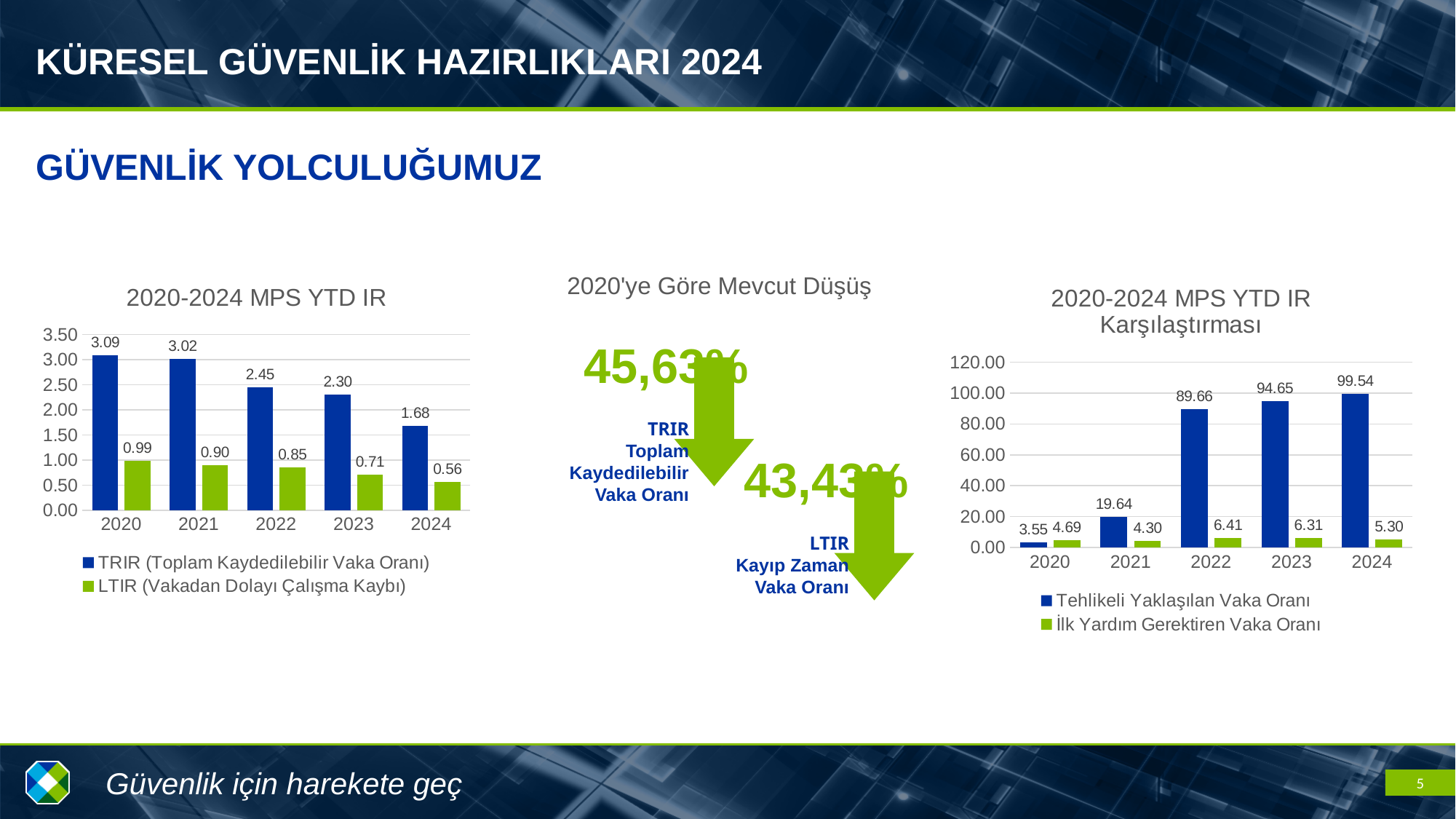
In the chart titled "2020-2024 MPS YTD IR Karşılaştırması", what is the Tehlikeli Yaklaşılan Vaka Oranı value for 2023? 94.65 In the chart titled "2020-2024 MPS YTD IR", does the TRIR value rise or fall from 2020 to 2024? fall In the chart titled "2020-2024 MPS YTD IR", what is the LTIR value for 2024? 0.56 In the chart titled "2020-2024 MPS YTD IR", what is the TRIR value for 2022? 2.45 In the chart titled "2020-2024 MPS YTD IR", how many series does the legend list? 2 In the chart titled "2020-2024 MPS YTD IR", what is the difference between the TRIR values for 2020 and 2024? 1.41 In the chart titled "2020-2024 MPS YTD IR Karşılaştırması", what is the İlk Yardım Gerektiren Vaka Oranı value for 2021? 4.30 In the chart titled "2020-2024 MPS YTD IR", which year has the highest TRIR value? 2020 What kind of chart is the chart titled "2020-2024 MPS YTD IR Karşılaştırması"? bar chart In the chart titled "2020-2024 MPS YTD IR", which year has the lowest LTIR value? 2024 In the chart titled "2020-2024 MPS YTD IR Karşılaştırması", which is larger in 2020: Tehlikeli Yaklaşılan Vaka Oranı or İlk Yardım Gerektiren Vaka Oranı? İlk Yardım Gerektiren Vaka Oranı In the chart titled "2020-2024 MPS YTD IR Karşılaştırması", which year has the highest Tehlikeli Yaklaşılan Vaka Oranı value? 2024